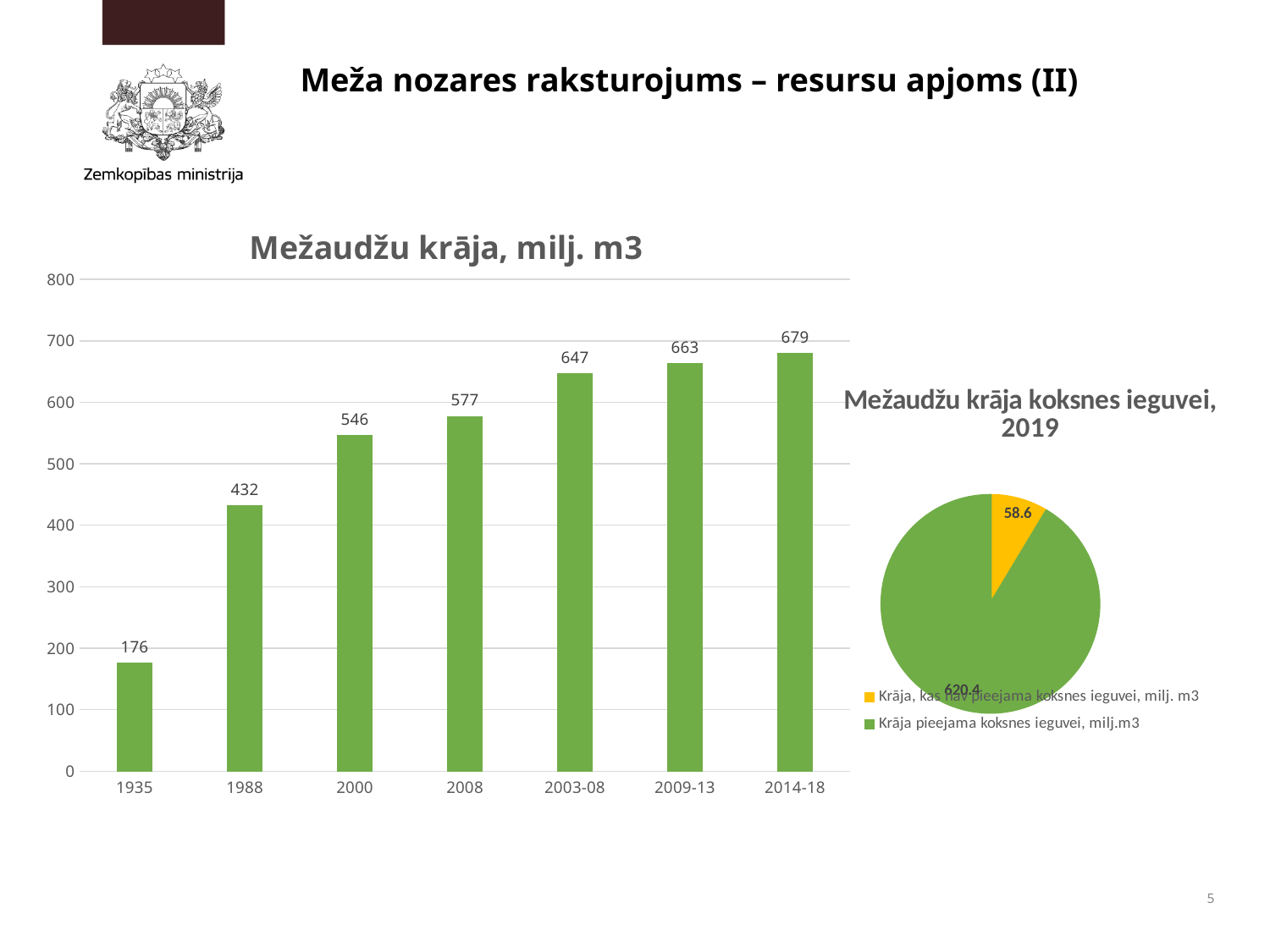
In the 'Mežaudžu krāja, milj. m3' chart, what is the difference between the values for 2014-18 and 1935? 503 In the 'Mežaudžu krāja koksnes ieguvei, 2019' pie chart, what is the value of 'Krāja pieejama koksnes ieguvei, milj.m3'? 620.4 In the 'Mežaudžu krāja, milj. m3' chart, what is the value for 2003-08? 647 In the 'Mežaudžu krāja koksnes ieguvei, 2019' pie chart, what is the value of the yellow slice 'Krāja, kas nav pieejama koksnes ieguvei, milj. m3'? 58.6 In the 'Mežaudžu krāja, milj. m3' chart, how many categories are shown on the x axis? 7 In the 'Mežaudžu krāja, milj. m3' chart, which category has the lowest value? 1935 In the 'Mežaudžu krāja, milj. m3' chart, what is the value for 1935? 176 In the 'Mežaudžu krāja koksnes ieguvei, 2019' pie chart, how many entries does the legend list? 2 In the 'Mežaudžu krāja, milj. m3' chart, which is larger, the value for 2000 or the value for 2008? 2008 In the 'Mežaudžu krāja, milj. m3' chart, do the values rise or fall from left to right along the x axis? rise In the 'Mežaudžu krāja, milj. m3' chart, which category has the highest value? 2014-18 What kind of chart is 'Mežaudžu krāja, milj. m3'? bar chart